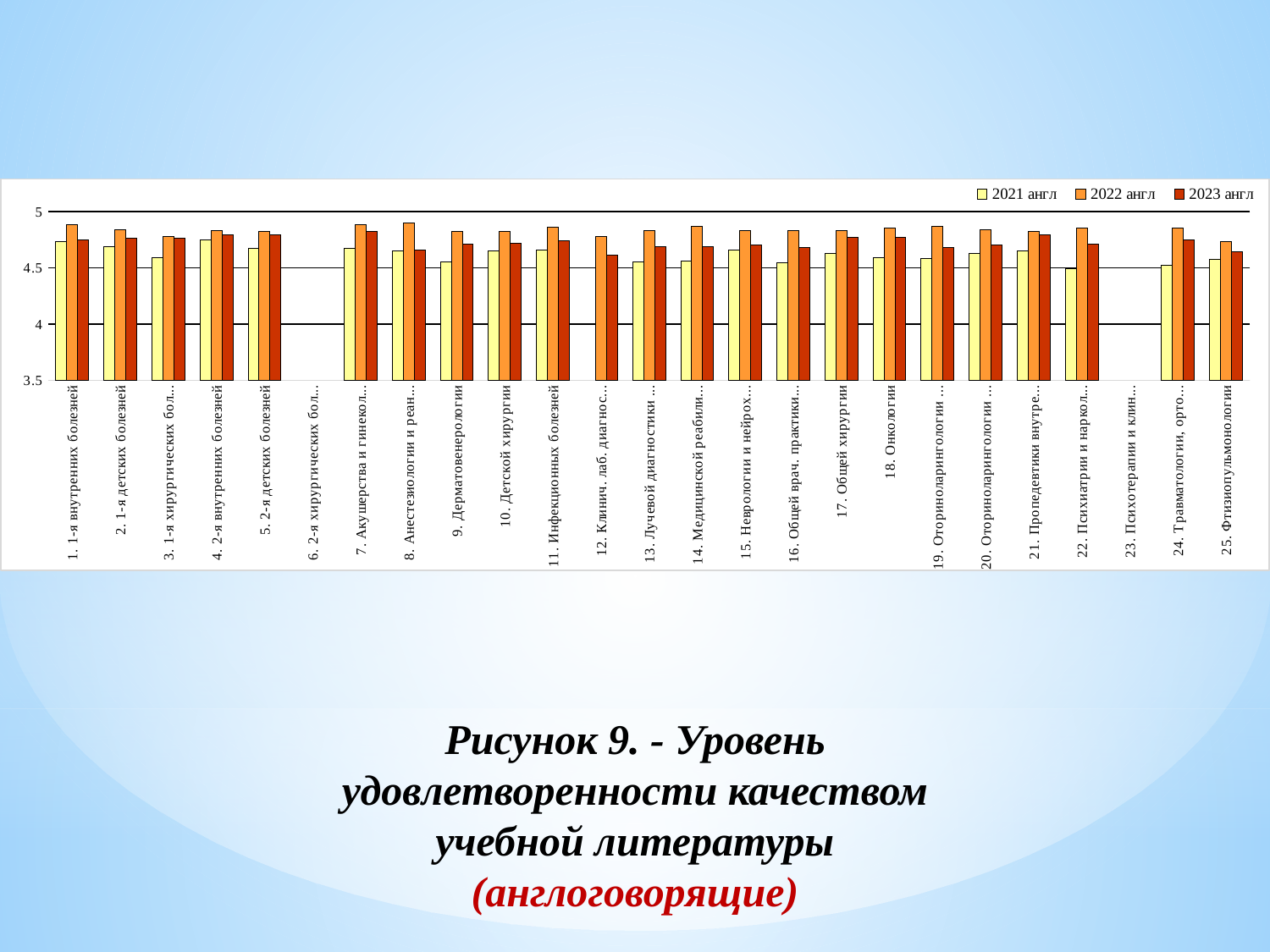
In category 8. Анестезиологии и реан..., which series has the highest bar? 2022 англ How many categories are labelled along the x axis? 25 Is the value for 2022 англ in category 1. 1-я внутренних болезней greater or less than 4.5? greater In category 9. Дерматовенерологии, which is larger: the 2021 англ value or the 2022 англ value? 2022 англ In category 1. 1-я внутренних болезней, which is larger: the 2021 англ value or the 2022 англ value? 2022 англ In category 12. Клинич. лаб. диагнос..., which series has the highest bar? 2022 англ Is the value for 2021 англ in category 9. Дерматовенерологии greater or less than 4? greater What are the three series listed in the legend? 2021 англ, 2022 англ, 2023 англ How many series does the legend list? 3 Is the value for 2023 англ in category 25. Фтизиопульмонологии greater or less than 5? less What kind of chart is shown on the slide? bar chart Which two categories have no bars plotted? 6. 2-я хирургических бол... and 23. Психотерапии и клин...